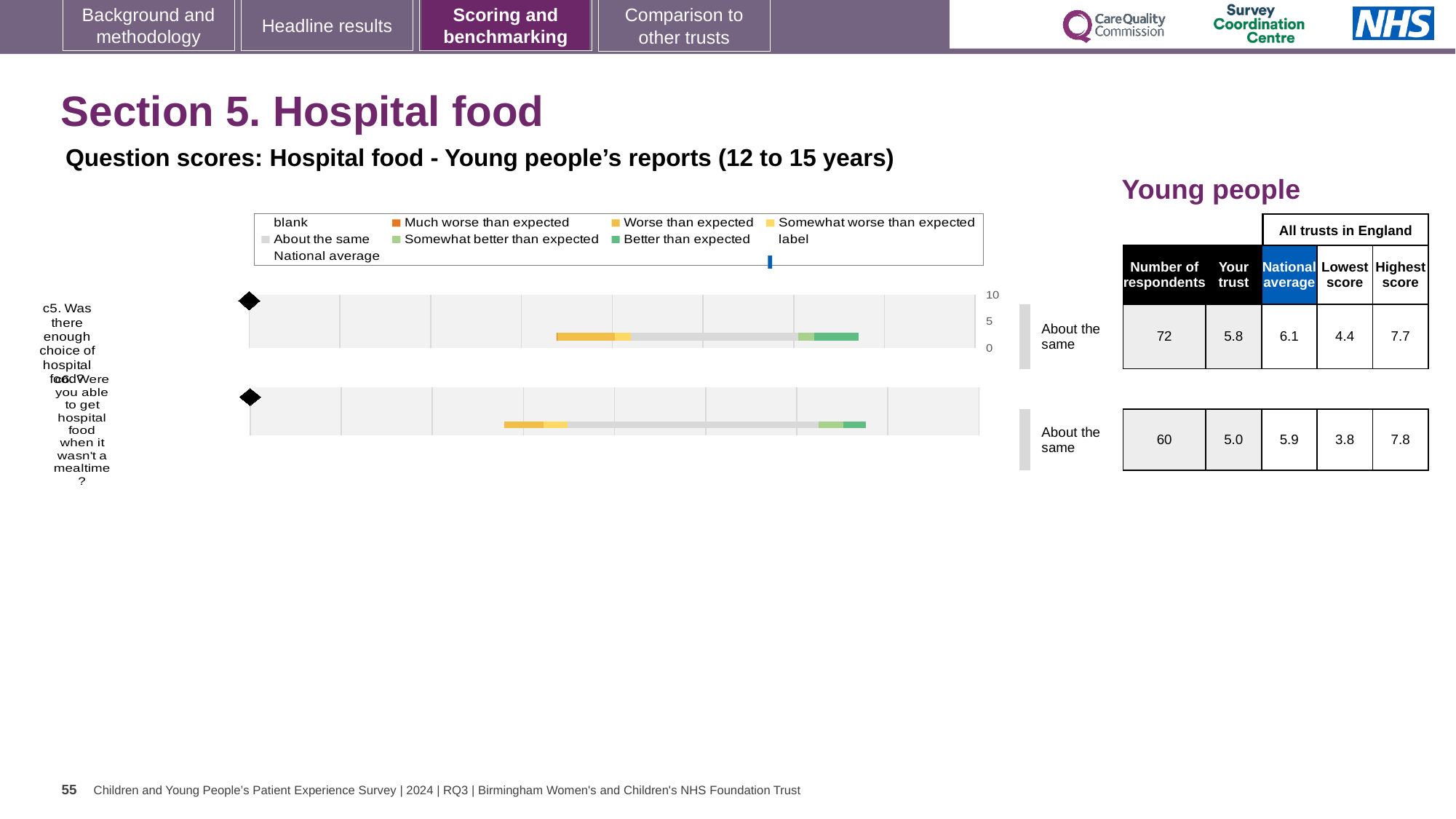
What is the highest score among all trusts in England for question c5? 7.7 What is the number of respondents for question c5 (Was there enough choice of hospital food?)? 72 What kind of chart is used to show the question scores for hospital food? bar chart What is the national average score for question c6 (Were you able to get hospital food when it wasn't a mealtime?)? 5.9 What benchmark category is shown for question c5 (Was there enough choice of hospital food?)? About the same What is the difference between the national average and the 'Your trust' score for question c6? 0.9 How many questions are plotted in the hospital food chart? 2 What is the highest value shown on the chart's score axis? 10 What is the 'Your trust' score for question c5 (Was there enough choice of hospital food?)? 5.8 What is the lowest score among all trusts in England for question c6? 3.8 Which question has the higher 'Your trust' score, c5 or c6? c5 What is the difference between the highest and lowest scores for question c5? 3.3